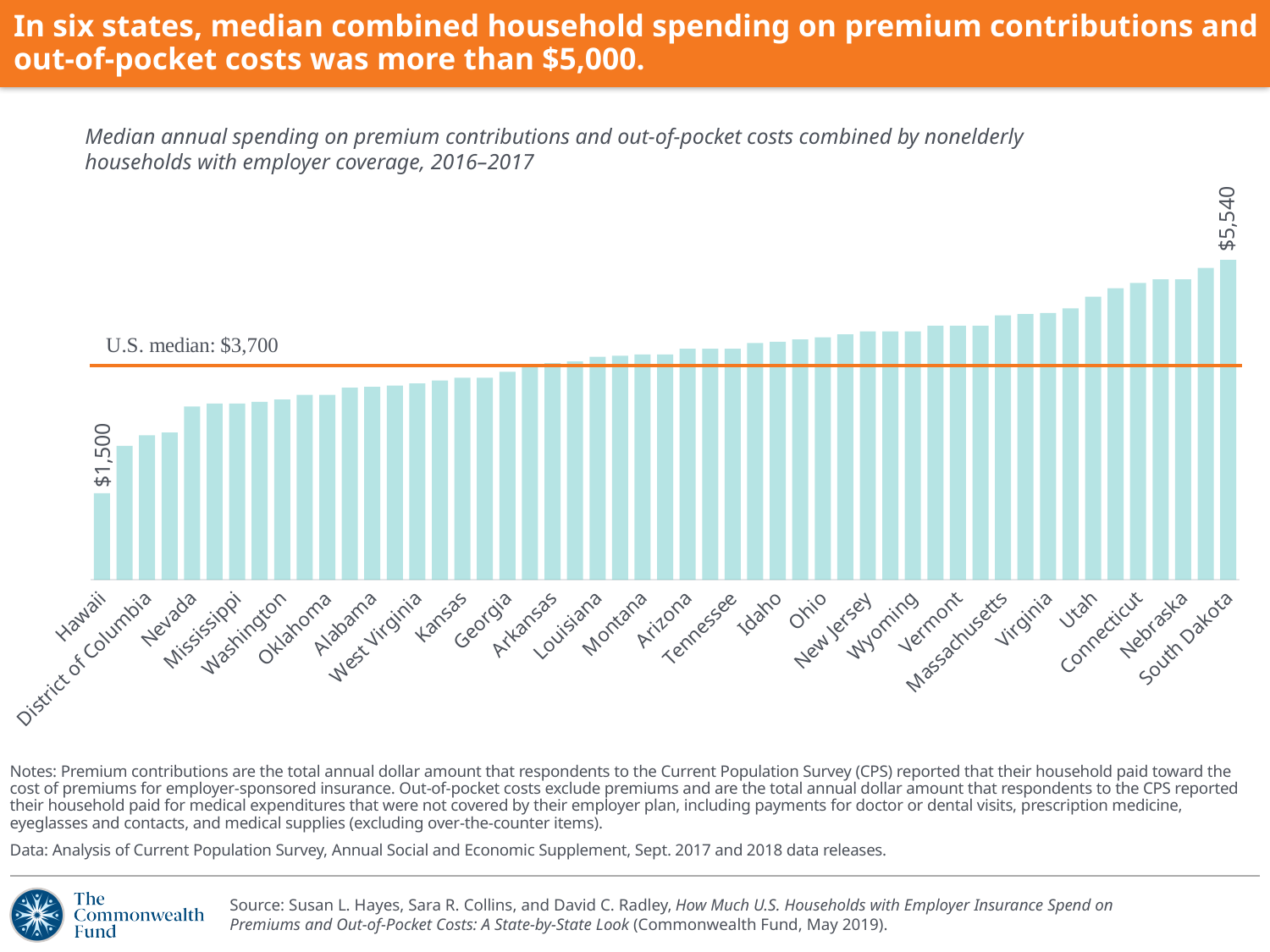
What kind of chart is shown on the slide? Bar chart Which has a lower median spending value, Hawaii or Nebraska? Hawaii What is the median annual spending value shown for Hawaii? $1,500 What is the difference between the median spending in South Dakota and in Hawaii? $4,040 Is the value for Utah greater or less than the U.S. median of $3,700? greater What U.S. median value is marked by the horizontal line on the chart? $3,700 Which state has the highest median annual spending on premium contributions and out-of-pocket costs? South Dakota Is the value for Nevada greater or less than the U.S. median of $3,700? less Do the bar values rise or fall moving from left to right along the x axis? Rise What is the median annual spending value shown for South Dakota? $5,540 Which has a higher median spending value, Washington or Virginia? Virginia Which state has the lowest median annual spending on premium contributions and out-of-pocket costs? Hawaii